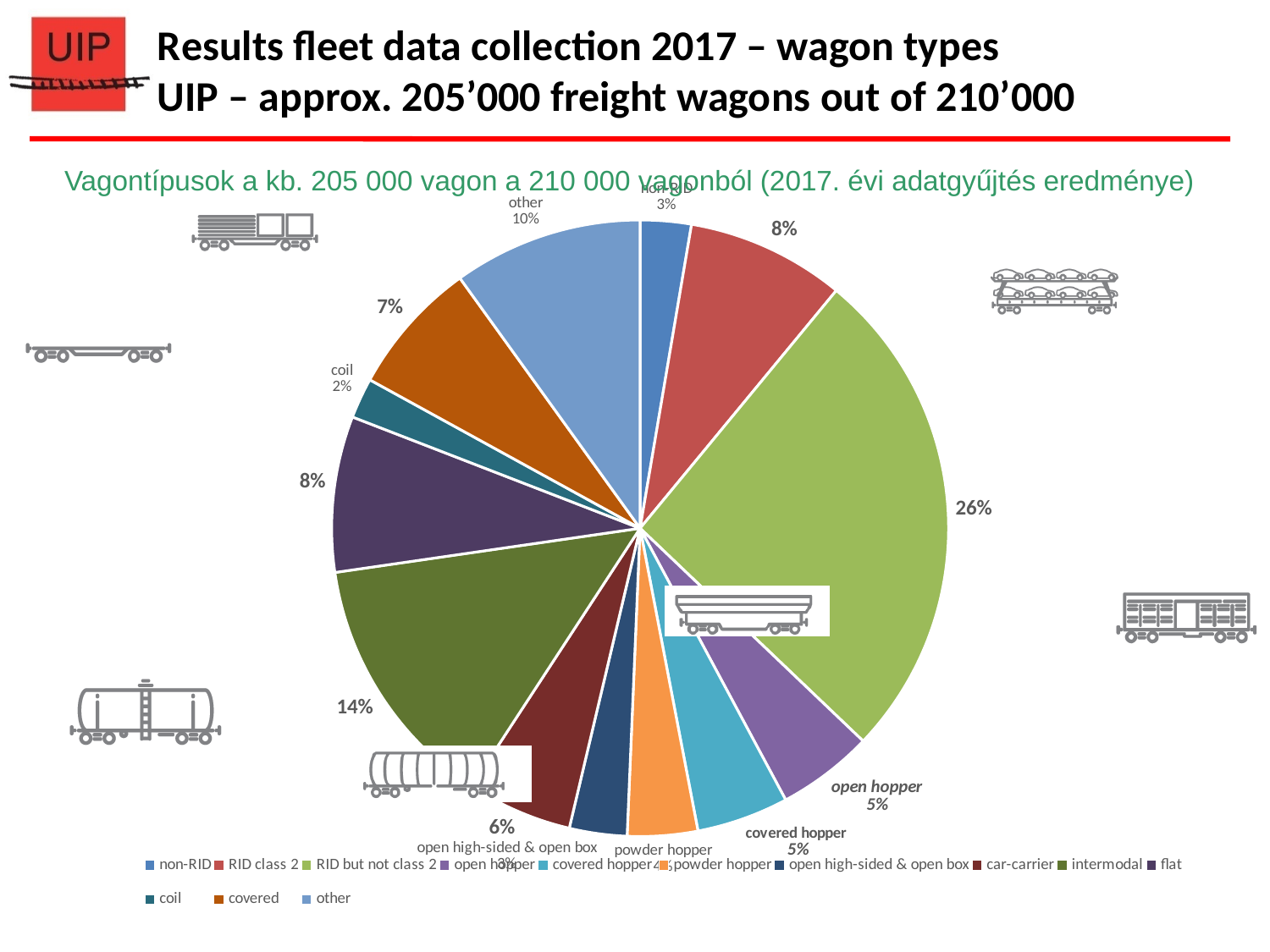
Which wagon type has the largest share of the pie chart? RID but not class 2 Which slice is larger, 'intermodal' or 'other'? intermodal Which wagon type has the smallest share of the pie chart? coil What share of the pie does the 'coil' slice have? 2% What share of the pie does the 'other' slice have? 10% What share of the pie does the 'RID but not class 2' slice have? 26% What share of the pie does the 'covered' slice have? 7% By how many percentage points does the 'RID but not class 2' share exceed the 'intermodal' share? 12 percentage points What share of the pie does the 'open hopper' slice have? 5% What share of the pie does the 'intermodal' slice have? 14% What kind of chart is shown on the slide? pie chart How many wagon-type categories does the legend of the pie chart list? 13